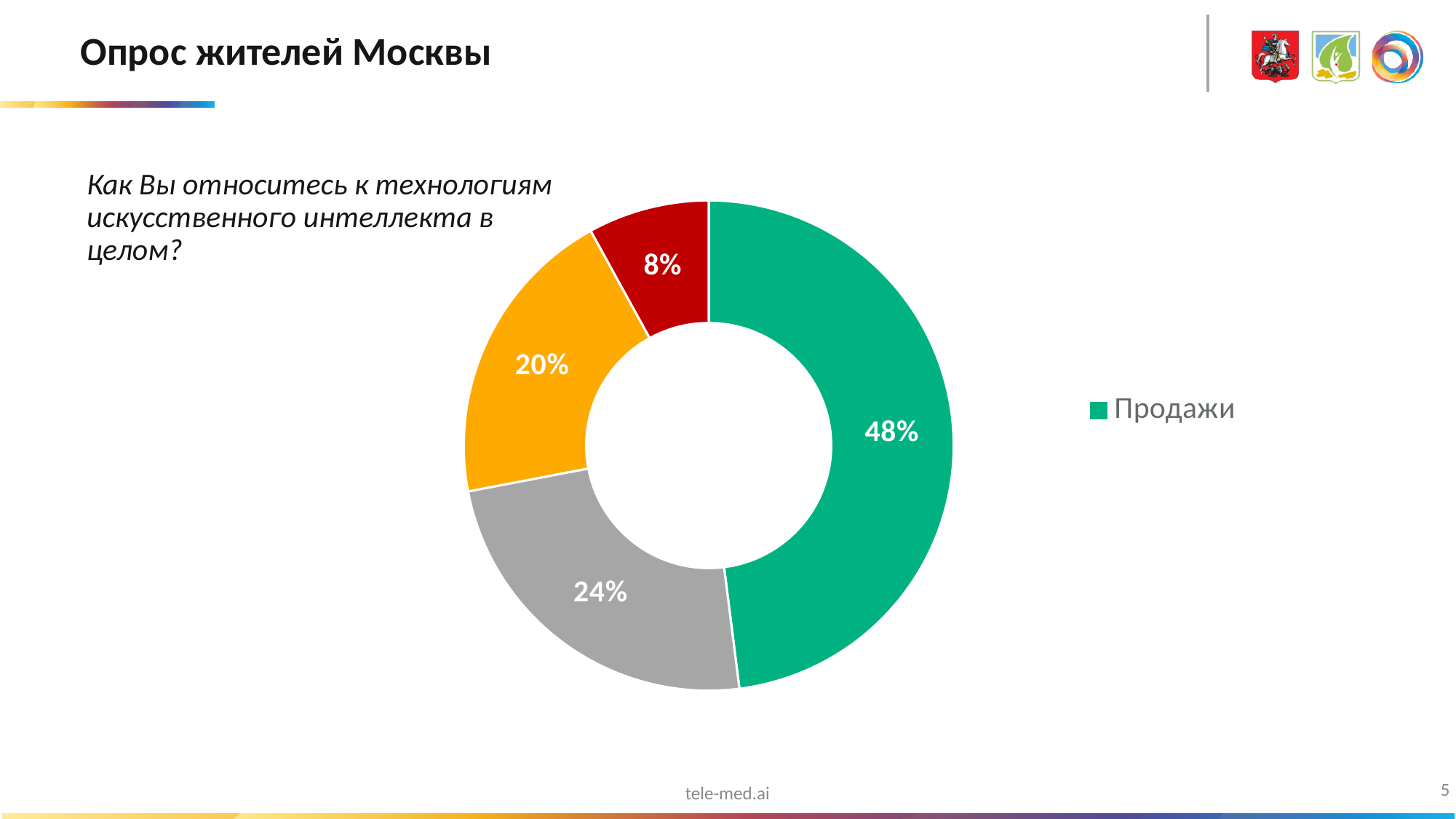
How many slices does the chart have? 4 What is the difference between the green slice and the grey slice? 24% What percentage is shown on the orange slice of the chart? 20% What percentage is shown on the green slice of the chart? 48% Which slice of the chart has the smallest share? The red slice (8%) What percentage is shown on the red slice of the chart? 8% What is the legend entry shown next to the chart? Продажи What kind of chart is shown on the slide? Doughnut (pie) chart Which slice of the chart has the largest share? The green slice (48%) How many entries does the chart legend list? 1 What percentage is shown on the grey slice of the chart? 24% Which is larger, the orange slice or the red slice? The orange slice